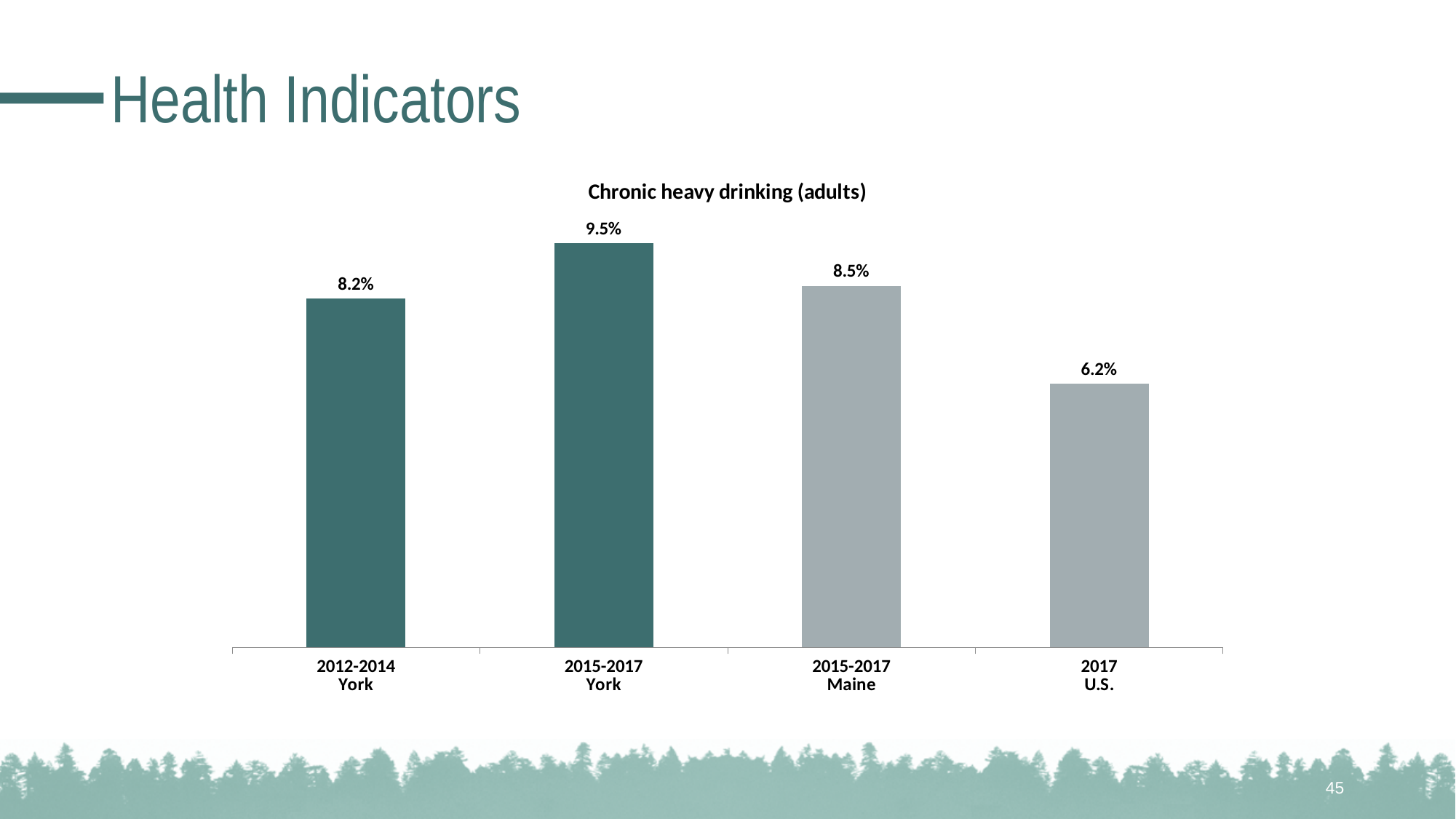
Which is larger, the value for 2015-2017 York or the value for 2015-2017 Maine? 2015-2017 York Which category has the highest value? 2015-2017 York What is the value for 2017 U.S.? 6.2% Which category has the lowest value? 2017 U.S. What kind of chart is shown on the slide? Bar chart What is the value for 2015-2017 Maine? 8.5% What is the value for 2012-2014 York? 8.2% What is the difference between the 2015-2017 York value and the 2012-2014 York value? 1.3% How many bars are shown in the chart? 4 What is the title of the chart? Chronic heavy drinking (adults) What is the value for 2015-2017 York? 9.5% What is the difference between the 2015-2017 Maine value and the 2017 U.S. value? 2.3%